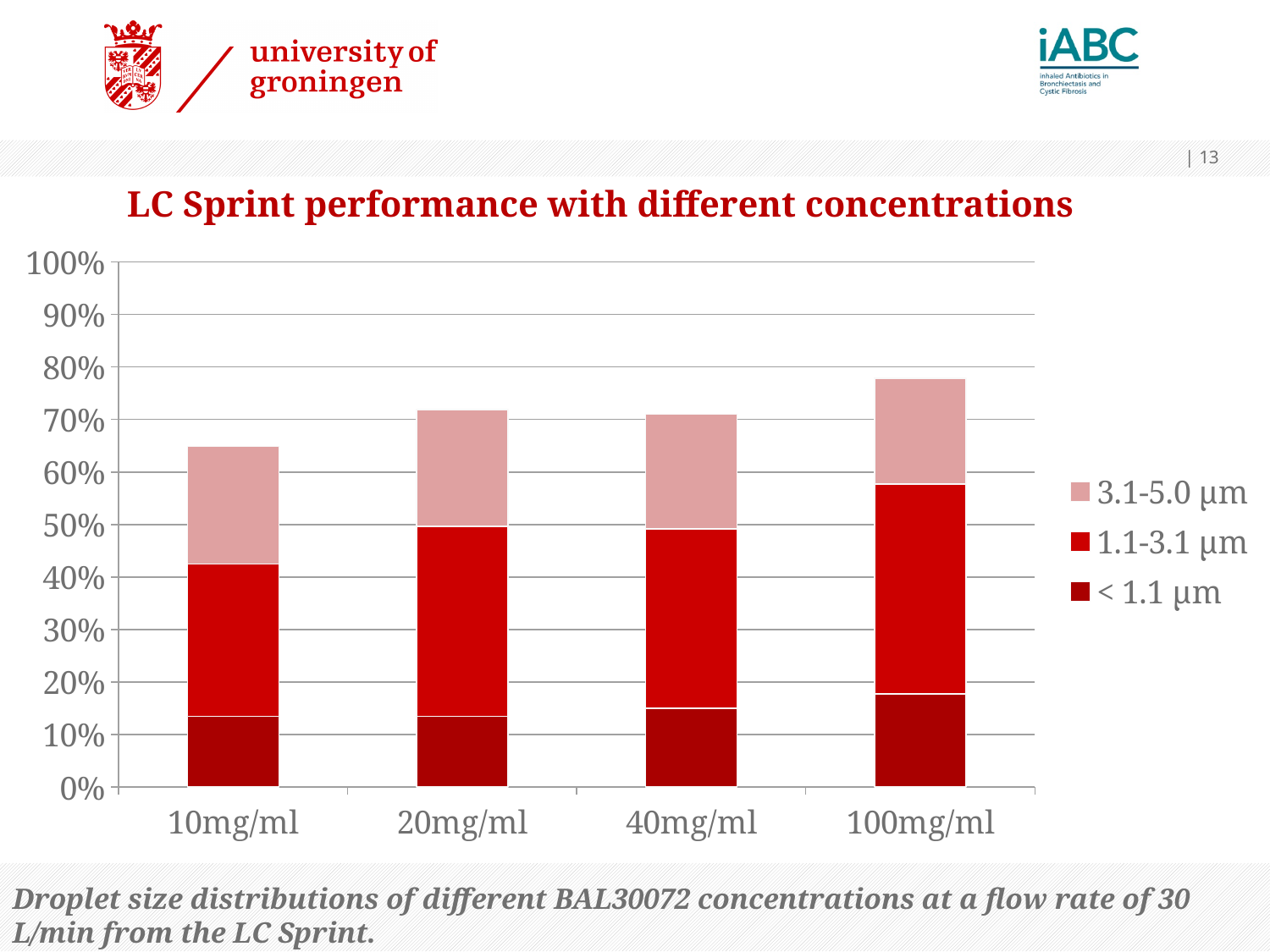
Which has the larger total stacked bar, 10mg/ml or 100mg/ml? 100mg/ml Is the total stacked bar for 100mg/ml greater or less than 70%? greater Which series is shown in the darkest red colour? < 1.1 µm Which has the larger < 1.1 µm segment, 10mg/ml or 100mg/ml? 100mg/ml What kind of chart is shown on the slide? Stacked bar chart Which concentration has the tallest total stacked bar? 100mg/ml Is the < 1.1 µm segment for 10mg/ml greater or less than 20%? less How many concentration categories are shown on the x axis? 4 How many series does the legend list? 3 What is the title of the chart? LC Sprint performance with different concentrations Is the total stacked bar for 10mg/ml greater or less than 70%? less Which concentration has the shortest total stacked bar? 10mg/ml